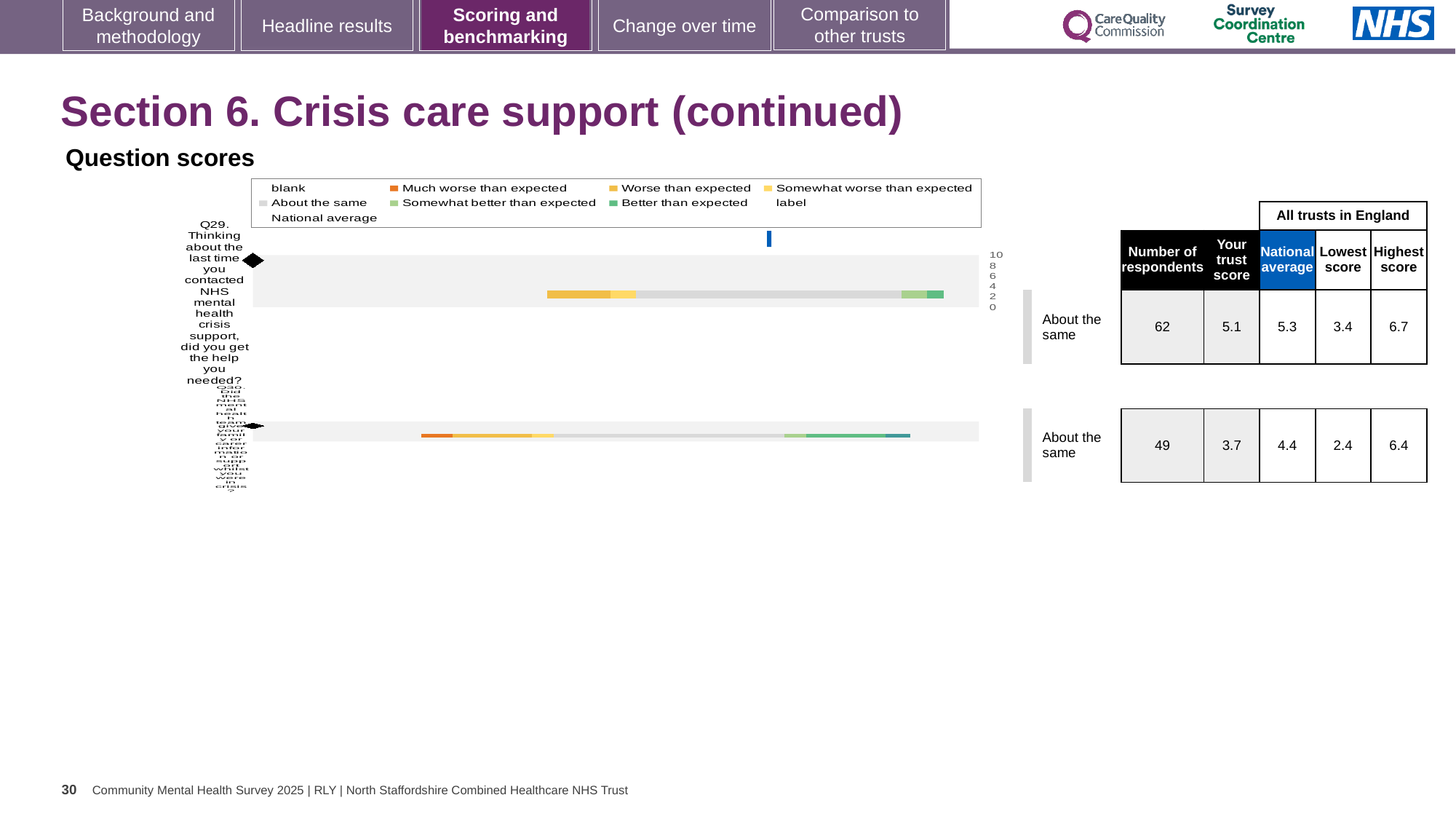
In the table beside the chart, what is the difference between the highest score and lowest score for Q30? 4.0 What kind of chart is shown under 'Question scores'? bar chart In the table beside the chart, what is the 'Your trust score' for Q29? 5.1 In the table beside the chart, what is the number of respondents for Q30? 49 How many questions (categories) are plotted in the chart? 2 In the table beside the chart, which question has the higher 'Your trust score', Q29 or Q30? Q29 In the table beside the chart, what is the difference between the national average and 'Your trust score' for Q30? 0.7 Which legend entry is shown in orange? Much worse than expected In the table beside the chart, what is the national average for Q29? 5.3 In the table beside the chart, what is the 'Your trust score' for Q30? 3.7 What is the highest value shown on the chart's axis? 10 How many entries does the chart legend list? 9